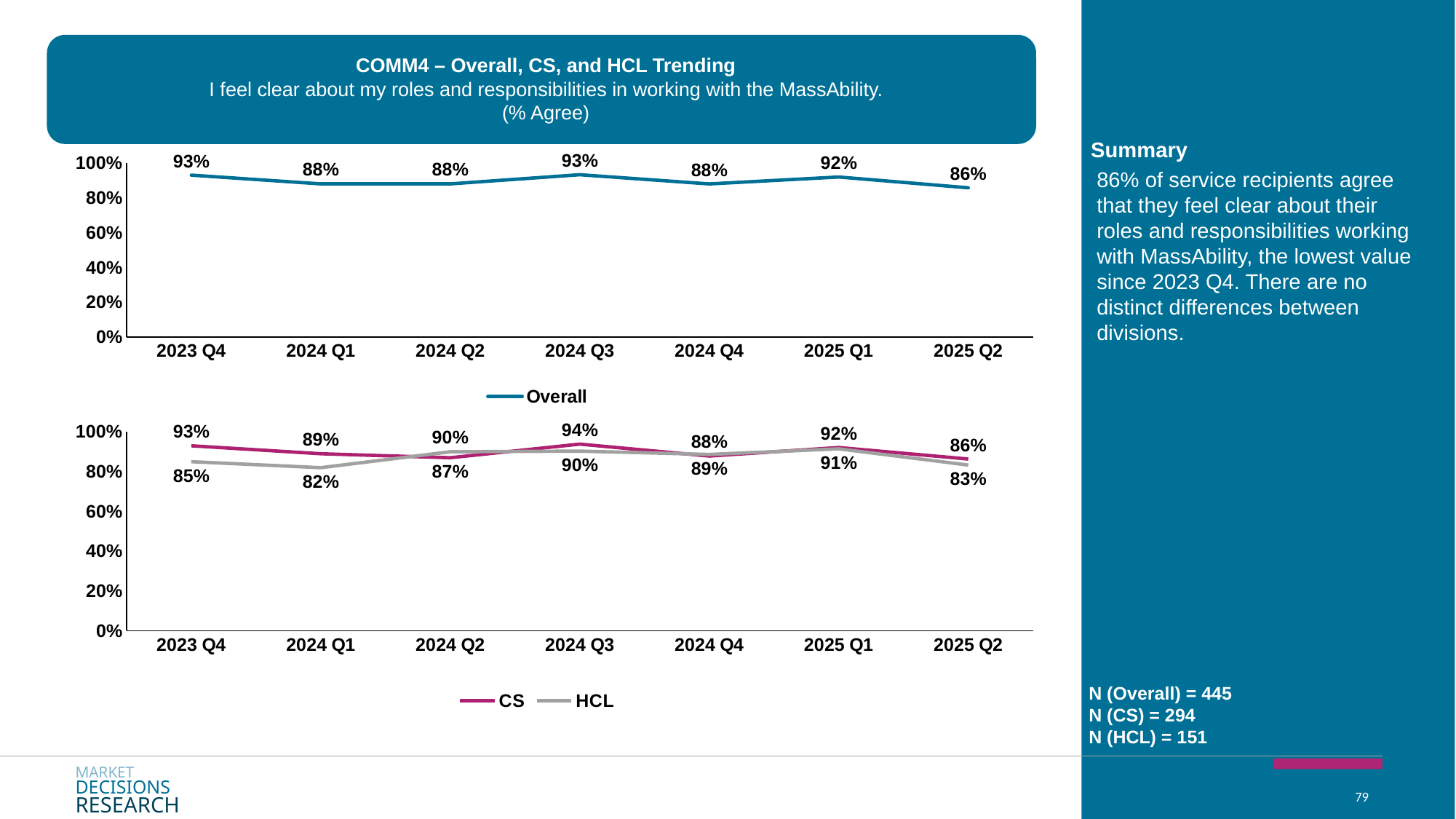
In the bottom chart, what colour is the CS line? Magenta/pink In the bottom chart, what is the CS value for 2024 Q3? 94% In the bottom chart, what is the HCL value for 2024 Q1? 82% In the bottom chart, which is larger for 2024 Q4, CS or HCL? HCL In the bottom chart, how many series does the legend list? 2 In the top chart (Overall), which quarter has the lowest value? 2025 Q2 In the bottom chart, which quarter has the lowest HCL value? 2024 Q1 In the top chart (Overall), how many quarters are plotted? 7 In the top chart (Overall), what is the value for 2025 Q1? 92% What type of chart is the top chart? Line chart In the top chart (Overall), what is the value for 2025 Q2? 86% In the bottom chart, what is the difference between the CS and HCL values for 2023 Q4? 8%